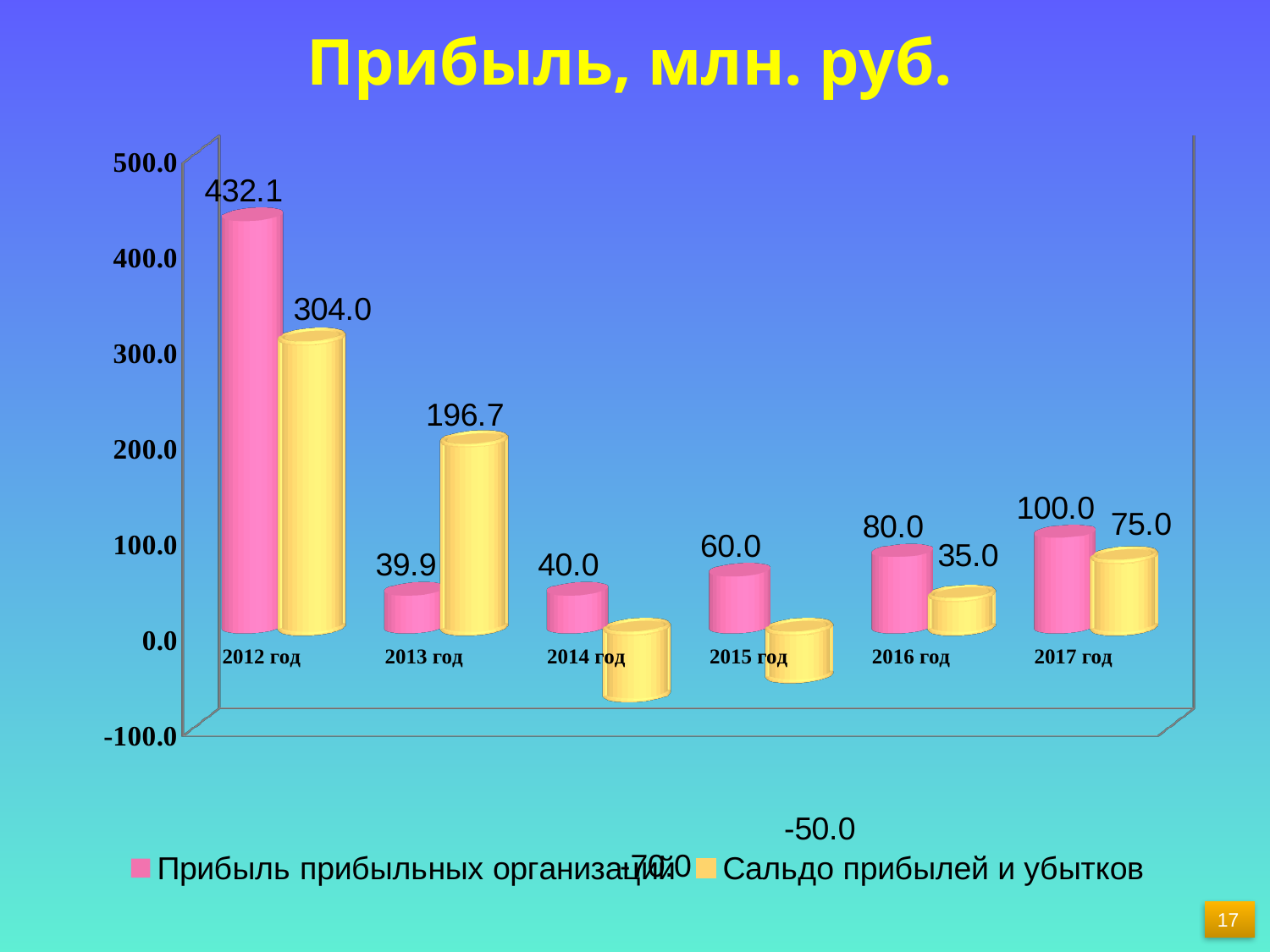
How many series does the legend list? 2 What is the difference between Прибыль прибыльных организаций and Сальдо прибылей и убытков in 2012 год? 128.1 How many years are shown on the x axis? 6 What is the value of Сальдо прибылей и убытков for 2016 год? 35.0 What is the value of Прибыль прибыльных организаций for 2017 год? 100.0 What is the value of Сальдо прибылей и убытков for 2013 год? 196.7 What type of chart is shown on the slide? bar chart Which year has the lowest value of Прибыль прибыльных организаций? 2013 год Is the value of Сальдо прибылей и убытков for 2014 год greater or less than 0.0? less What is the value of Прибыль прибыльных организаций for 2012 год? 432.1 Which year has the highest value of Прибыль прибыльных организаций? 2012 год In 2013 год, which is larger: Прибыль прибыльных организаций or Сальдо прибылей и убытков? Сальдо прибылей и убытков